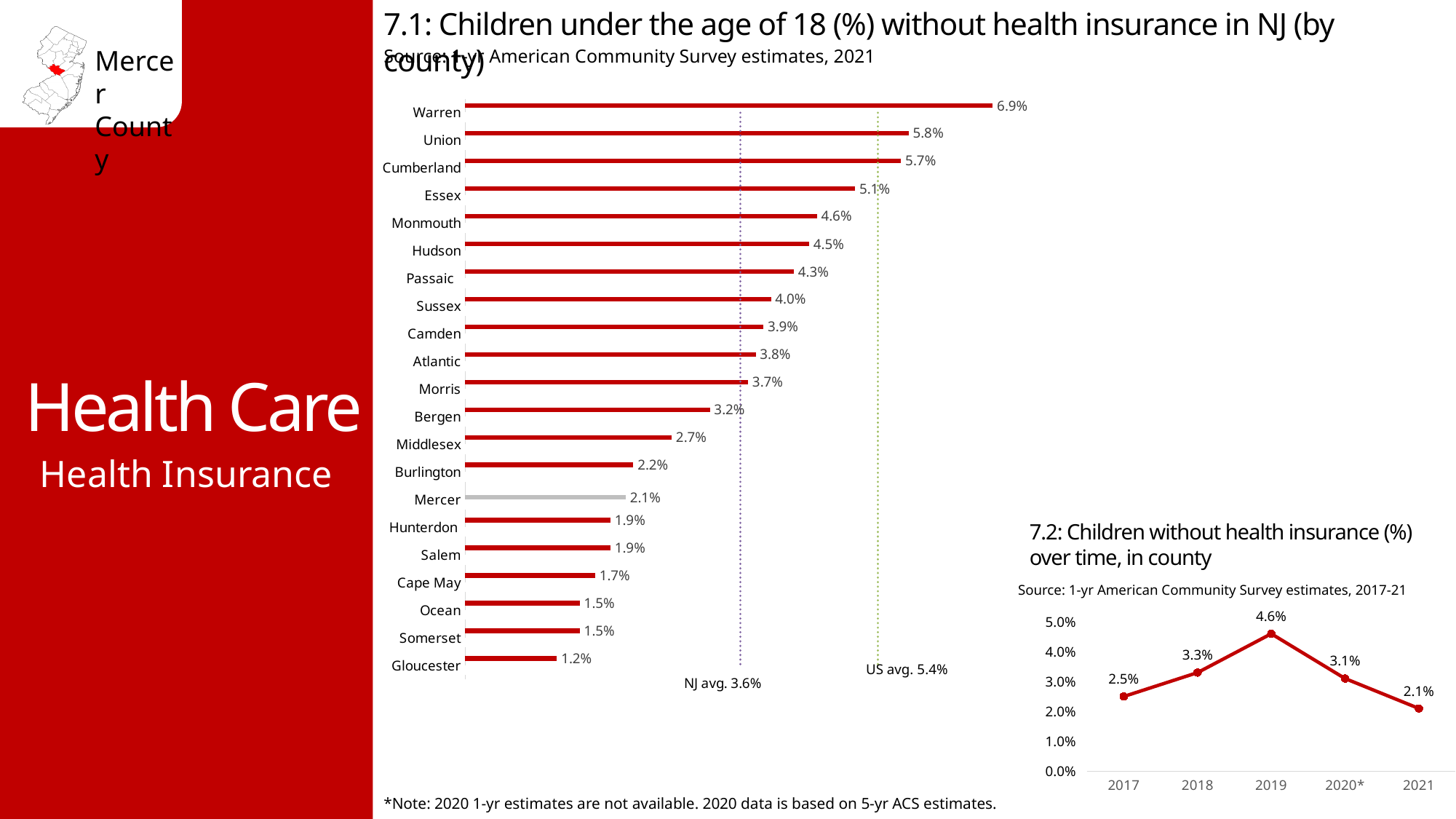
In chart 7.1 (children without health insurance by county), which county has the lowest value? Gloucester In chart 7.1 (children without health insurance by county), what is the NJ average shown by the dotted line? 3.6% In chart 7.1 (children without health insurance by county), what is the value for Mercer? 2.1% In chart 7.2 (children without health insurance over time), do the values rise or fall from 2019 to 2021? Fall In chart 7.2 (children without health insurance over time), what is the value for 2019? 4.6% In chart 7.2 (children without health insurance over time), what is the difference between 2019 and 2021? 2.5% In chart 7.1 (children without health insurance by county), which is larger, the value for Essex or the value for Hudson? Essex What kind of chart is chart 7.1 (children without health insurance by county)? Bar chart In chart 7.2 (children without health insurance over time), which year has the lowest value? 2021 In chart 7.1 (children without health insurance by county), which county has the highest value? Warren In chart 7.1 (children without health insurance by county), what is the difference between Warren and Mercer? 4.8% In chart 7.1 (children without health insurance by county), how many counties are shown? 21